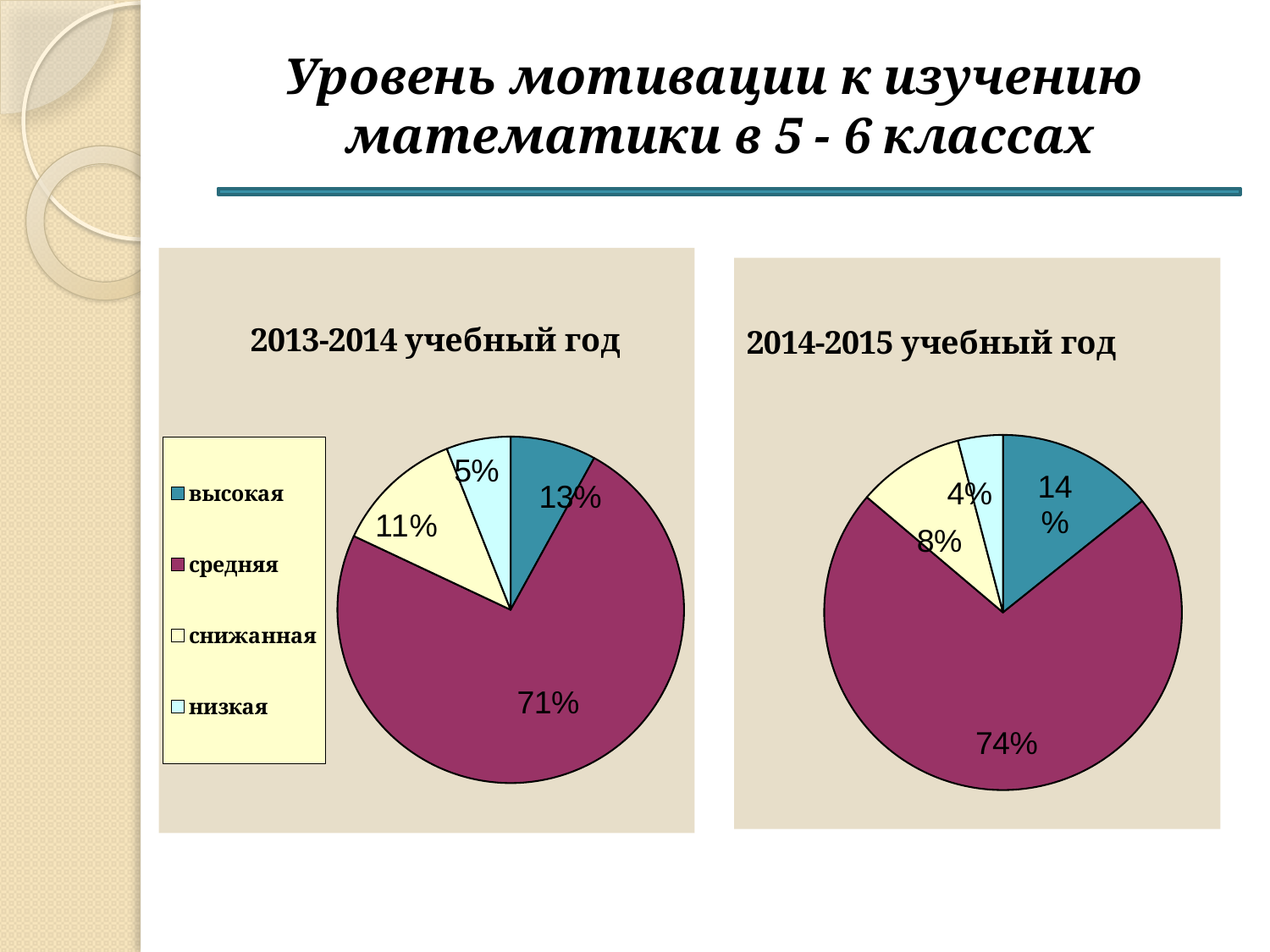
In the "2013-2014 учебный год" chart, what share does "высокая" have? 13% How many entries does the legend on the left chart list? 4 In the "2013-2014 учебный год" chart, which category has the smallest slice? низкая In the "2014-2015 учебный год" chart, which category has the largest slice? средняя In the "2013-2014 учебный год" chart, what share does "низкая" have? 5% What kind of chart is the "2013-2014 учебный год" chart? pie chart How many slices does the "2014-2015 учебный год" pie chart have? 4 In the "2013-2014 учебный год" chart, what is the difference between the "средняя" and "высокая" shares? 58% In the "2013-2014 учебный год" chart, what share does "средняя" have? 71% In the "2014-2015 учебный год" chart, what share does "средняя" have? 74% Which is larger: the "высокая" share in the "2013-2014 учебный год" chart or in the "2014-2015 учебный год" chart? 2014-2015 учебный год